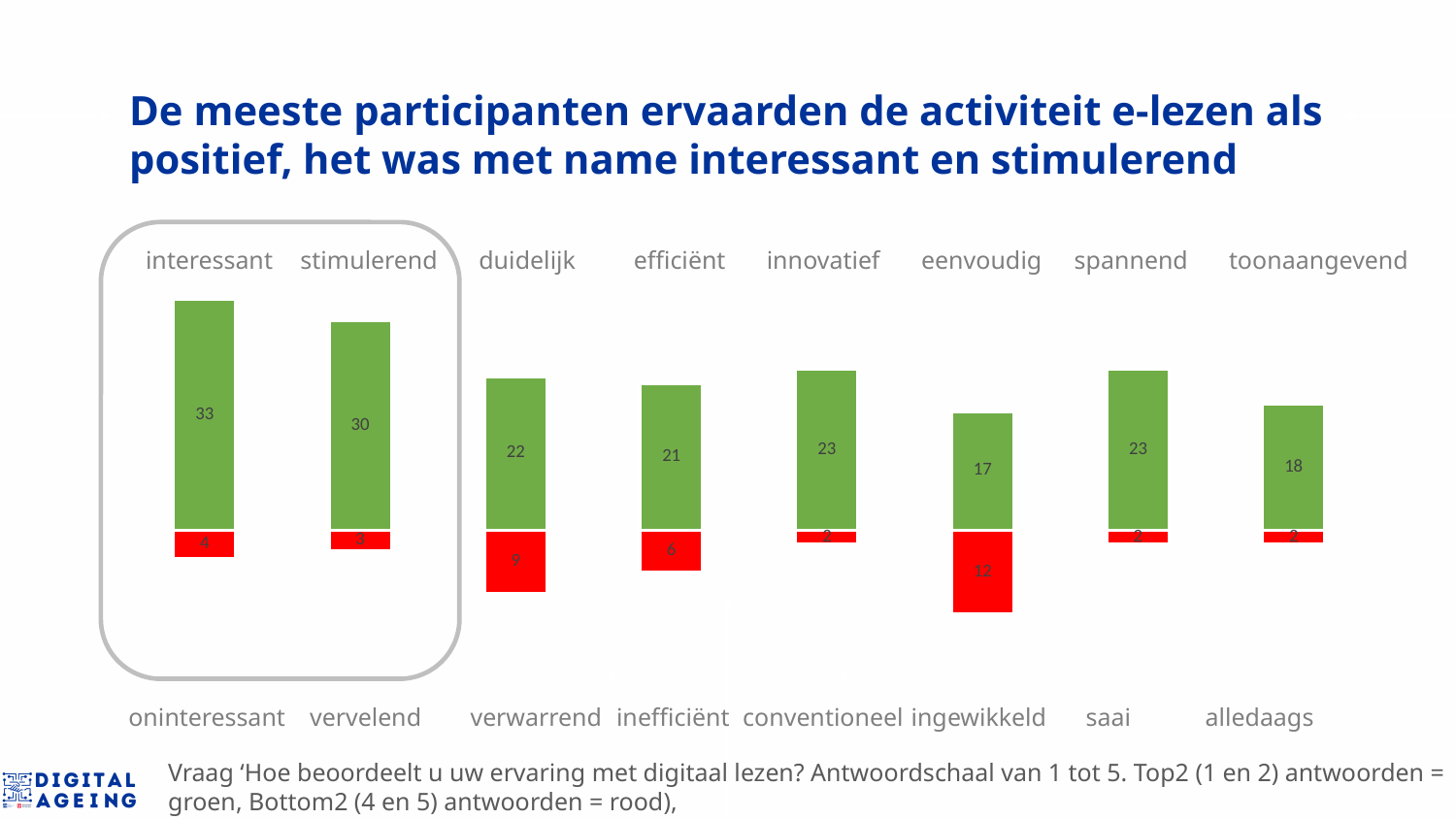
What is the red (negative) value for 'duidelijk'? 9 What kind of chart is shown on the slide? bar chart What is the red (negative) value for 'eenvoudig'? 12 What is the green (positive) value for 'stimulerend'? 30 What is the difference between the green values for 'interessant' and 'stimulerend'? 3 How many categories are shown in the chart? 8 Which category has the lowest green (positive) value? eenvoudig What is the total of the green and red values for 'interessant'? 37 Which category has the highest green (positive) value? interessant Which has the larger green value, 'duidelijk' or 'efficiënt'? duidelijk What is the green (positive) value for 'interessant'? 33 Which category has the largest red (negative) value? eenvoudig